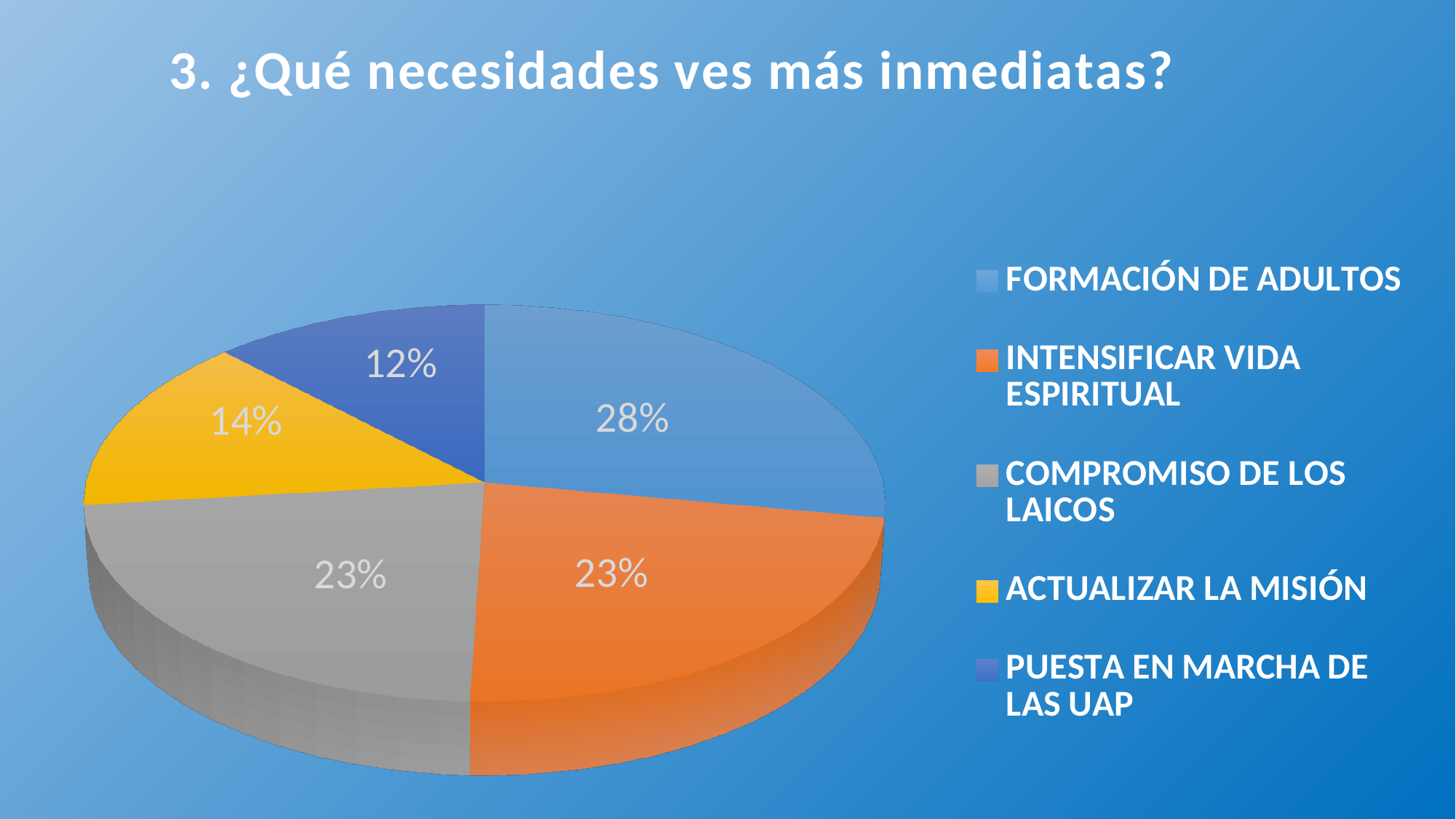
What percentage is shown for COMPROMISO DE LOS LAICOS? 23% What share of the pie does FORMACIÓN DE ADULTOS represent? 28% Which category has the largest slice of the pie? FORMACIÓN DE ADULTOS What is the difference in percentage points between FORMACIÓN DE ADULTOS and PUESTA EN MARCHA DE LAS UAP? 16% Which is larger, ACTUALIZAR LA MISIÓN or INTENSIFICAR VIDA ESPIRITUAL? INTENSIFICAR VIDA ESPIRITUAL What kind of chart is shown on the slide? Pie chart What percentage is shown for INTENSIFICAR VIDA ESPIRITUAL? 23% What percentage is shown for PUESTA EN MARCHA DE LAS UAP? 12% What colour is the slice for ACTUALIZAR LA MISIÓN? Yellow What percentage is shown for ACTUALIZAR LA MISIÓN? 14% How many categories are shown in the pie chart? 5 Which category has the smallest slice of the pie? PUESTA EN MARCHA DE LAS UAP